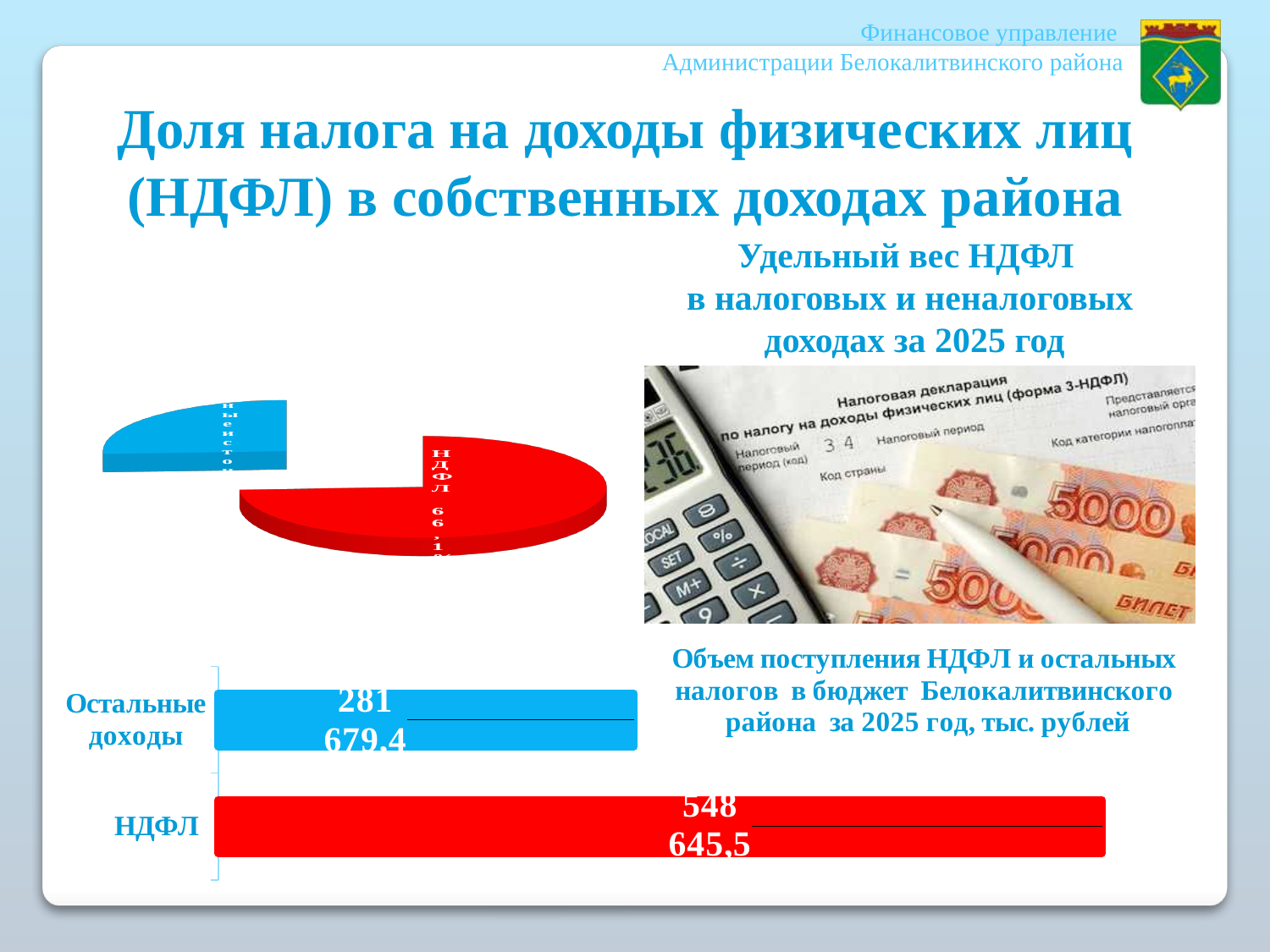
In the bar chart at the bottom of the slide, what colour is the bar for НДФЛ? red What kind of chart is the chart at the bottom left of the slide (Объем поступления НДФЛ и остальных налогов)? bar chart In the bar chart at the bottom of the slide, which category has the highest value? НДФЛ In the bar chart at the bottom of the slide, what is the value for Остальные доходы? 281 679.4 In the bar chart at the bottom of the slide, what is the value for НДФЛ? 548 645,5 In the bar chart at the bottom of the slide, which category has the lowest value? Остальные доходы In the bar chart at the bottom of the slide, which is larger: the value for НДФЛ or the value for Остальные доходы? НДФЛ In the pie chart in the middle left of the slide, which slice is larger: НДФЛ or the other slice? НДФЛ In the bar chart at the bottom of the slide, what is the difference between the value for НДФЛ and the value for Остальные доходы? 266 966,1 What kind of chart is the chart in the middle left of the slide (Удельный вес НДФЛ в налоговых и неналоговых доходах за 2025 год)? pie chart In the bar chart at the bottom of the slide, what is the total of the values for НДФЛ and Остальные доходы? 830 324,9 How many categories are shown in the bar chart at the bottom of the slide? 2